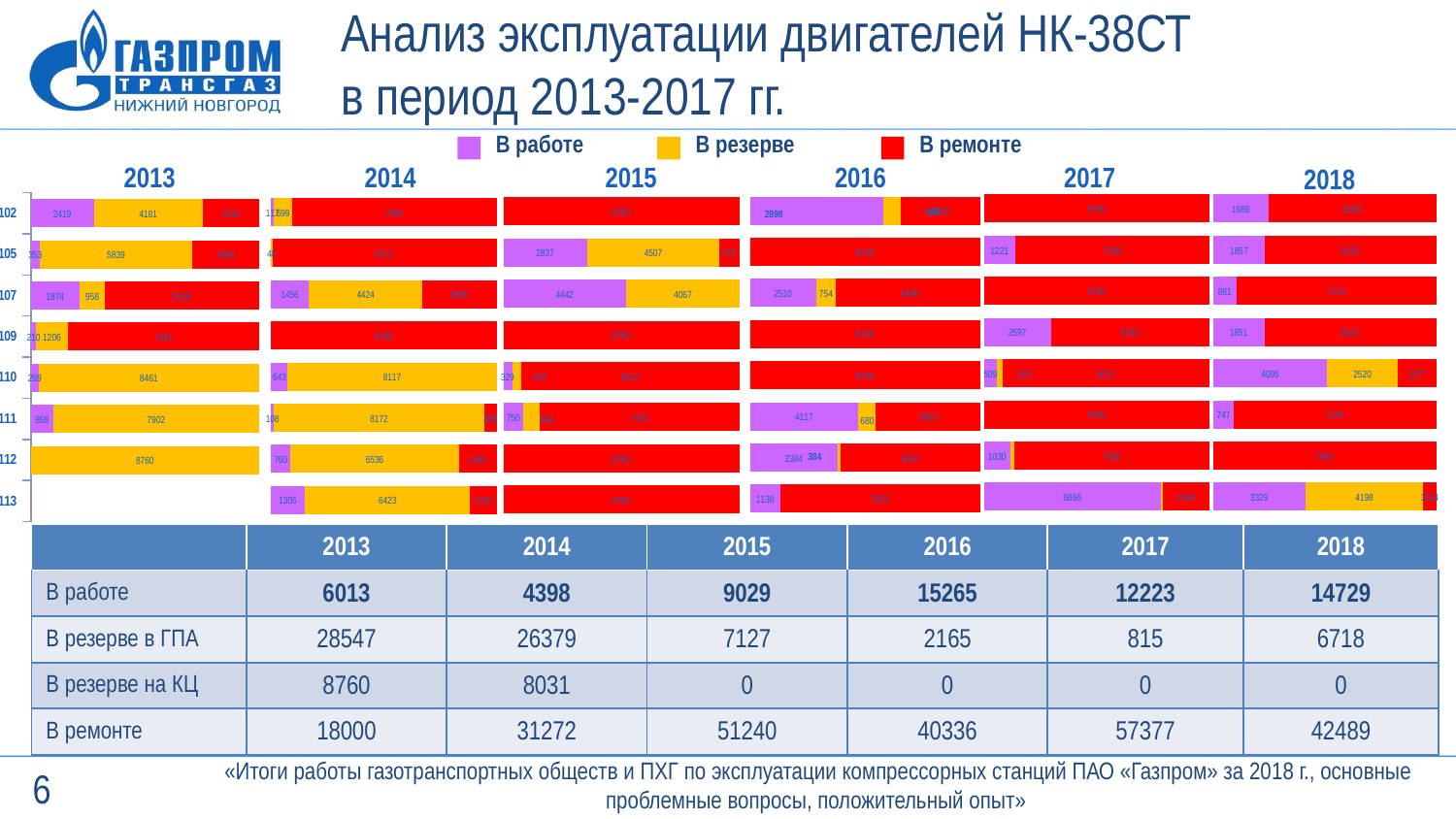
In the 2017 column, what is the В работе value for engine 113? 6866 In the 2014 column, what is the В резерве value for engine 113? 6423 In the 2013 column for engine 102, which is larger: the В работе value or the В резерве value? В резерве In the 2015 column, what is the В работе value for engine 107? 4442 How many series does the chart legend list? 3 In the 2014 column for engine 107, what is the difference between the В резерве value and the В работе value? 2968 What are the three legend entries of the chart? В работе, В резерве, В ремонте In the 2013 column, what is the В резерве value for engine 112? 8760 In the 2018 column, what is the В работе value for engine 110? 4095 How many years are shown as columns in the chart? 6 What kind of chart is shown on the slide? bar chart In the 2013 column, what is the В резерве value for engine 110? 8461